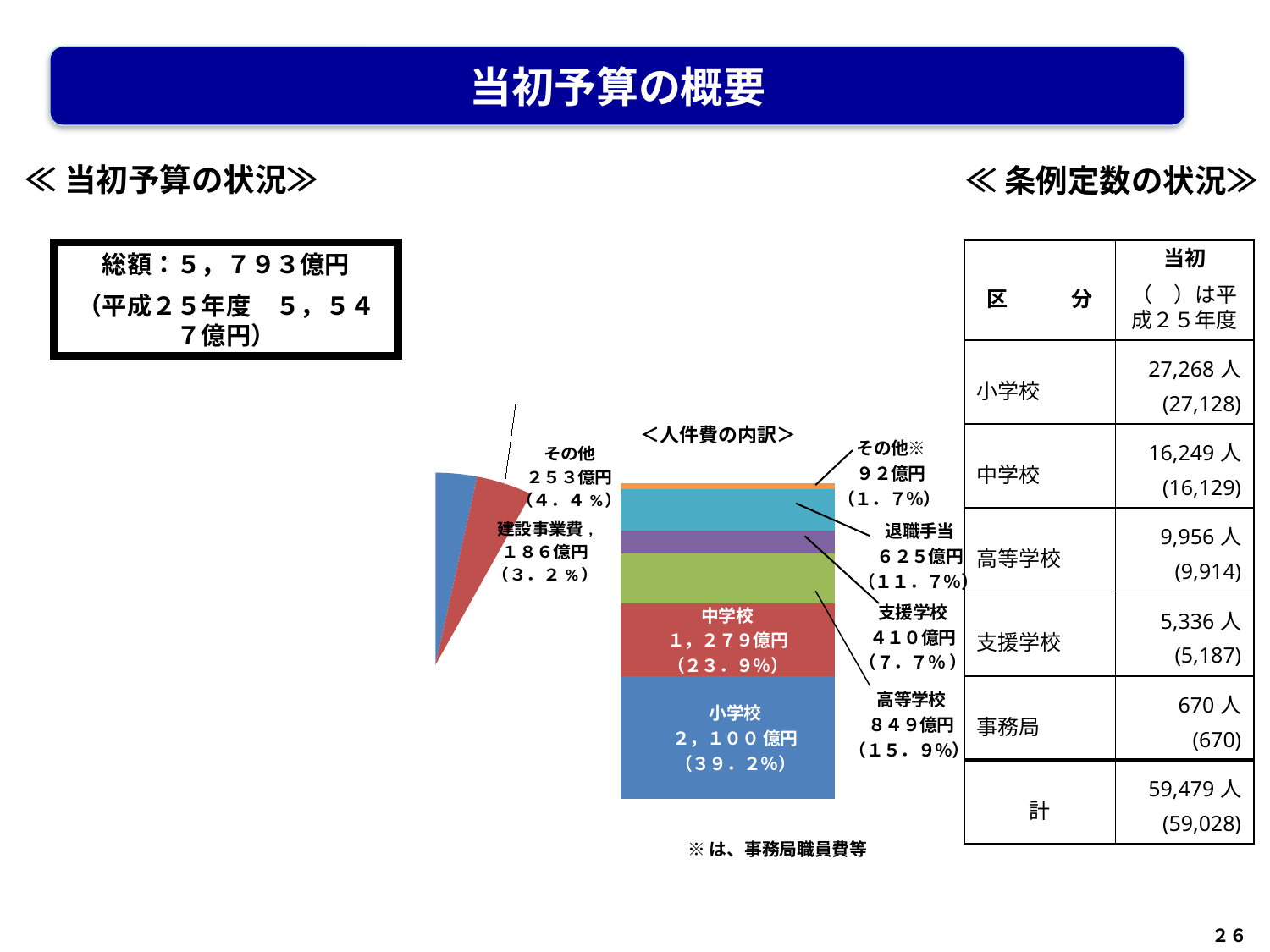
In the stacked bar chart titled ＜人件費の内訳＞, what is the value for 退職手当? ６２５億円（１１．７%） In the stacked bar chart titled ＜人件費の内訳＞, what is the value for 中学校? １，２７９億円（２３．９%） In the stacked bar chart titled ＜人件費の内訳＞, what is the value for 小学校? ２，１００億円（３９．２%） In the stacked bar chart titled ＜人件費の内訳＞, which segment is the largest? 小学校 What kind of chart is the ＜人件費の内訳＞ chart? Stacked bar chart In the stacked bar chart titled ＜人件費の内訳＞, what percentage is shown for 高等学校? １５．９% In the stacked bar chart titled ＜人件費の内訳＞, which segment is the smallest? その他※ In the stacked bar chart titled ＜人件費の内訳＞, how many segments make up the bar? 6 In the stacked bar chart titled ＜人件費の内訳＞, what is the difference in 億円 between 小学校 and 中学校? ８２１億円 In the stacked bar chart titled ＜人件費の内訳＞, which is larger, 支援学校 or 退職手当? 退職手当 In the pie chart on the left, which is larger, その他 or 建設事業費? その他 In the stacked bar chart titled ＜人件費の内訳＞, what is the total of all segments in 億円? ５，３５５億円